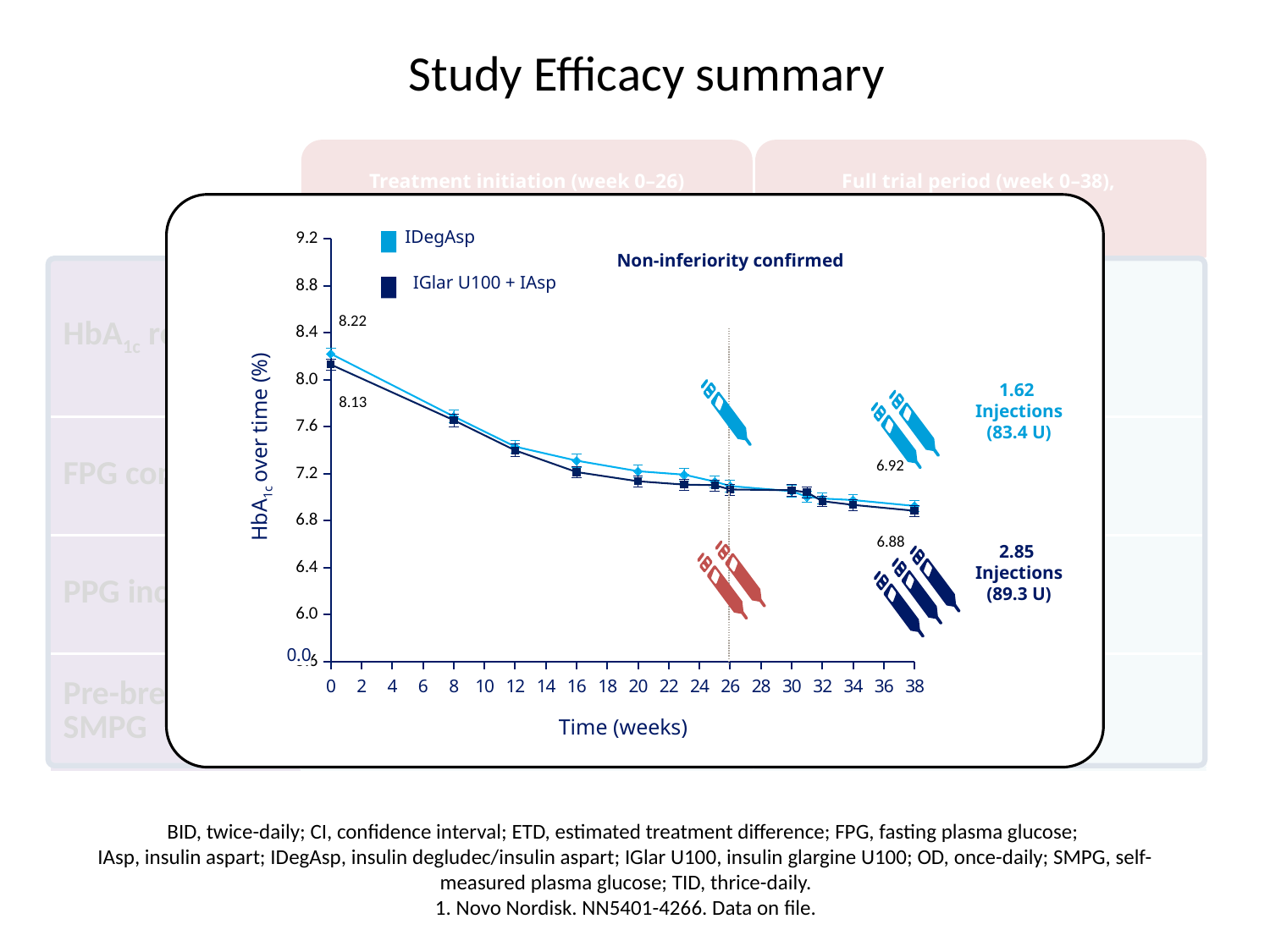
Do the HbA1c values rise or fall over the weeks shown? Fall What is the title of the x axis? Time (weeks) What kind of chart is shown on the slide? Line chart What is the HbA1c value for IDegAsp at week 0? 8.22 At week 0, which series has the higher HbA1c value, IDegAsp or IGlar U100 + IAsp? IDegAsp How many series does the legend list? 2 Is the HbA1c value for IDegAsp at week 8 greater or less than 8.0? less What is the HbA1c value for IDegAsp at week 38? 6.92 By how much did HbA1c for IGlar U100 + IAsp fall from week 0 to week 38? 1.25 By how much did HbA1c for IDegAsp fall from week 0 to week 38? 1.30 What is the HbA1c value for IGlar U100 + IAsp at week 38? 6.88 What is the HbA1c value for IGlar U100 + IAsp at week 0? 8.13